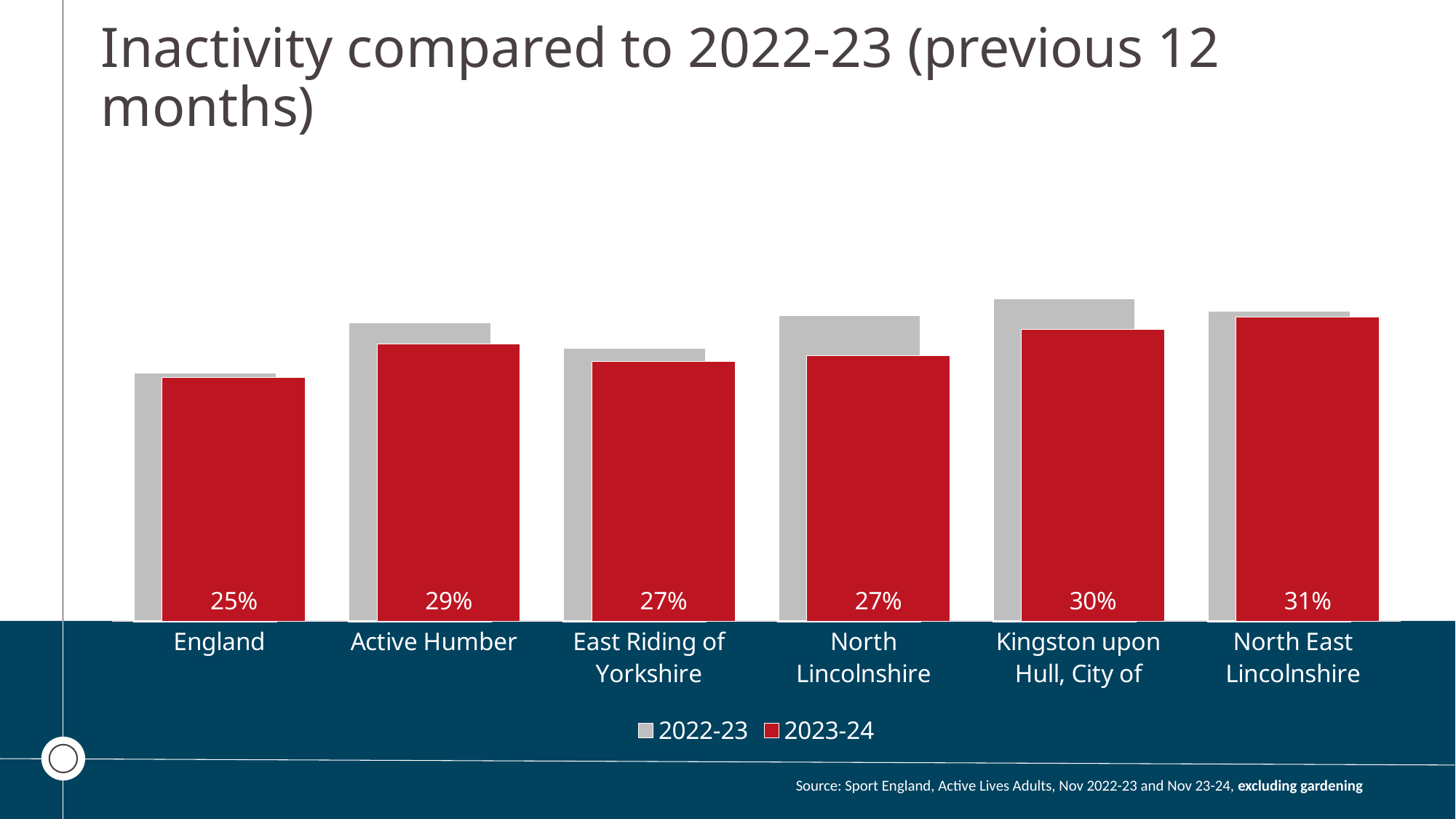
Which area has the highest 2023-24 inactivity value? North East Lincolnshire Which category has the lowest 2023-24 inactivity value? England What is the difference between the 2023-24 values for North East Lincolnshire and England? 6 percentage points How many series does the legend list? 2 How many categories are shown on the x axis of the chart? 6 What is the 2023-24 value for North East Lincolnshire? 31% What type of chart is shown on the slide? Bar chart What is the 2023-24 value for Active Humber? 29% Which has the larger 2023-24 value, Active Humber or East Riding of Yorkshire? Active Humber What is the 2023-24 value for Kingston upon Hull, City of? 30% For Kingston upon Hull, City of, which series has the taller bar, 2022-23 or 2023-24? 2022-23 What is the 2023-24 inactivity value for England? 25%